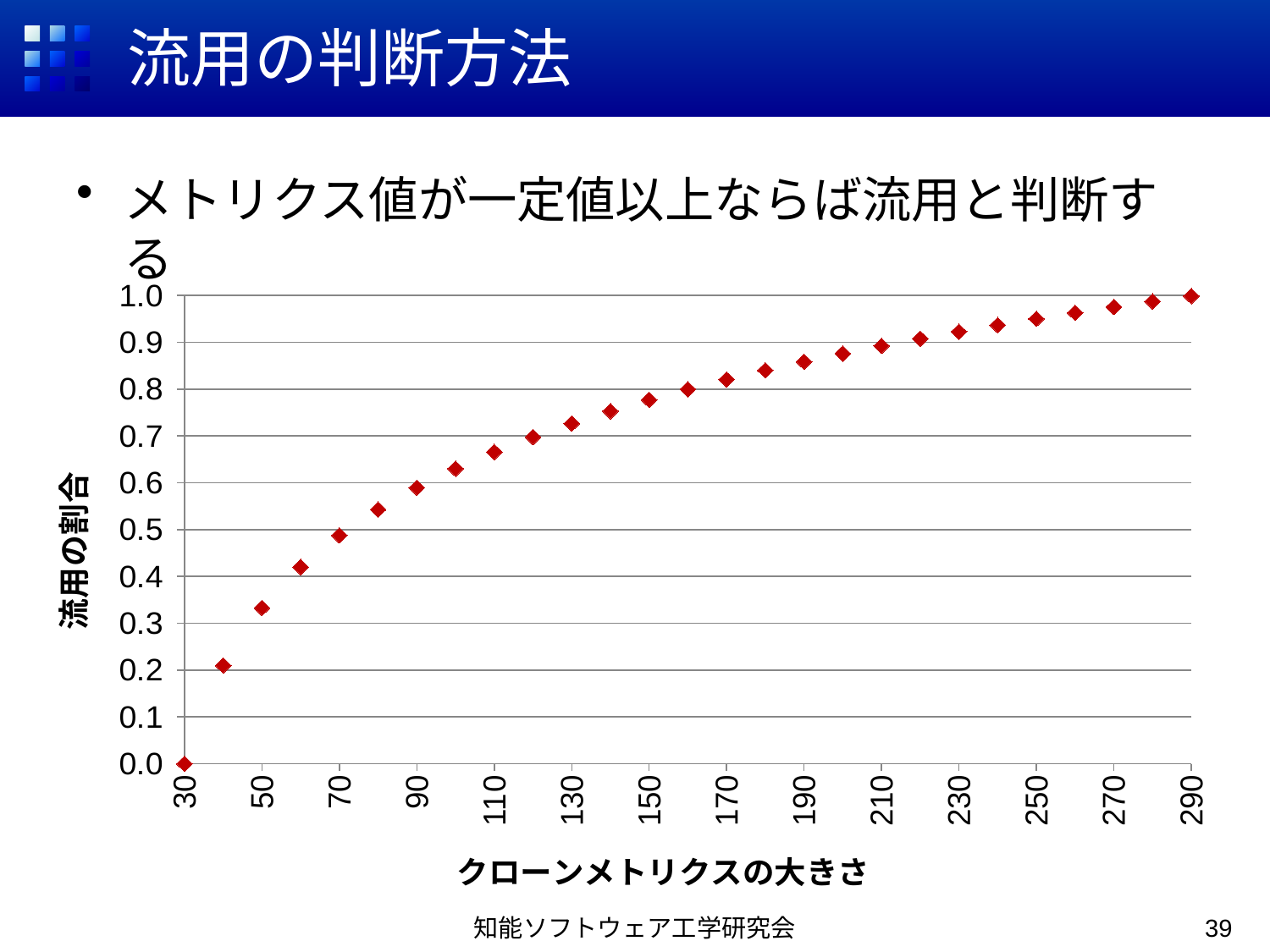
Is the value of 流用の割合 at クローンメトリクスの大きさ 200 greater or less than 0.8? greater Which has the larger 流用の割合: クローンメトリクスの大きさ 100 or 200? 200 Do the values of 流用の割合 rise or fall as クローンメトリクスの大きさ increases? rise Is the value of 流用の割合 at クローンメトリクスの大きさ 150 greater or less than 0.7? greater How many data points are plotted in the chart? 27 What is the value of 流用の割合 at クローンメトリクスの大きさ 30? 0.0 At which value of クローンメトリクスの大きさ is 流用の割合 lowest? 30 Is the value of 流用の割合 at クローンメトリクスの大きさ 50 greater or less than 0.4? less What is the title of the x axis of the chart? クローンメトリクスの大きさ At which value of クローンメトリクスの大きさ is 流用の割合 highest? 290 What kind of chart is shown on the slide? scatter chart